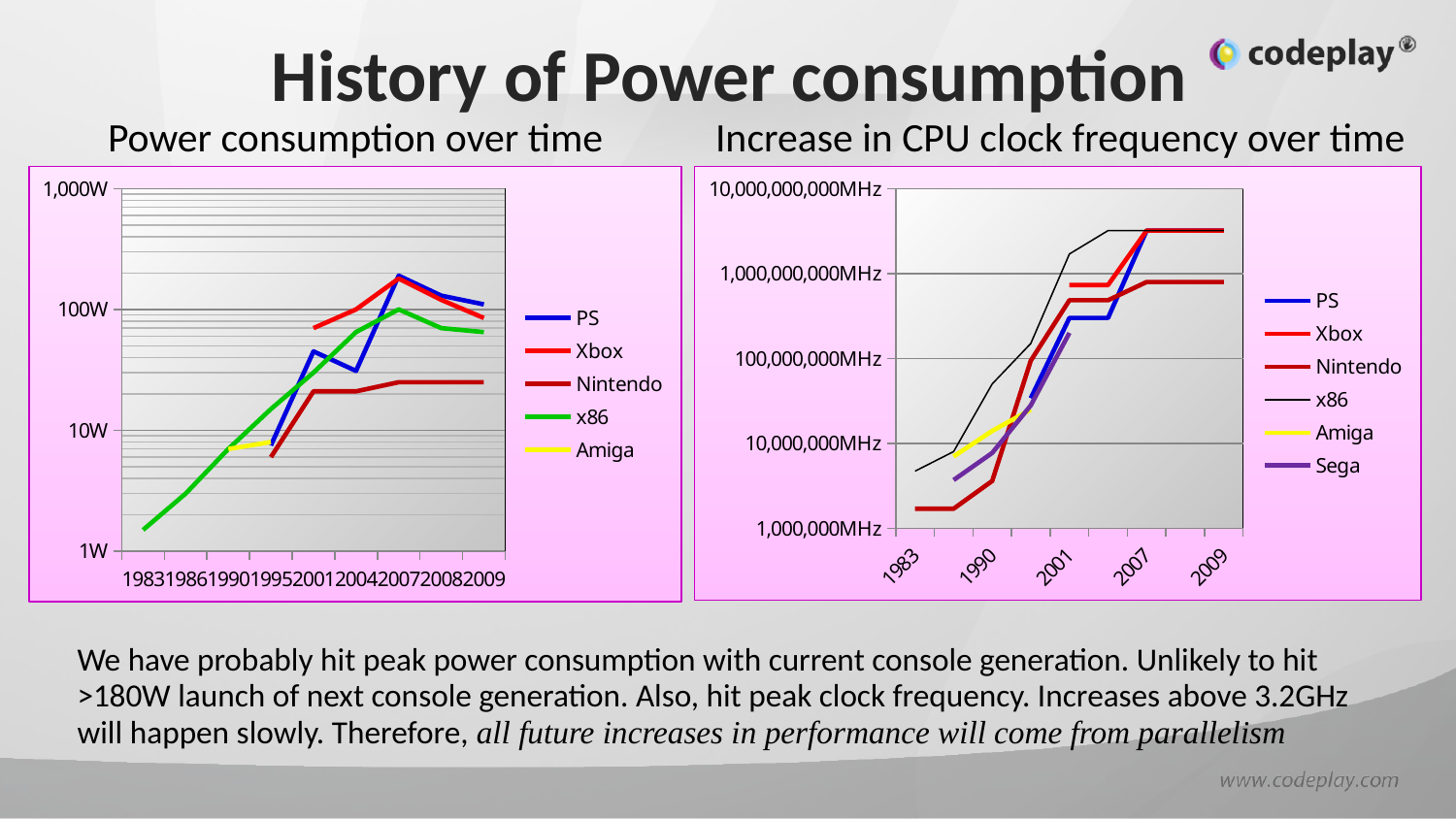
How many series does the legend of the 'Power consumption over time' chart list? 5 In the 'Power consumption over time' chart, does the x86 line rise or fall from 1983 to 2007? rise In the 'Increase in CPU clock frequency over time' chart, which is higher in 2009, Xbox or Nintendo? Xbox In the 'Power consumption over time' chart, how many years are labelled on the x axis? 9 In the 'Increase in CPU clock frequency over time' chart, is the value for Nintendo in 1983 greater or less than 10,000,000MHz? less What kind of chart is the 'Increase in CPU clock frequency over time' chart? line chart Which series appears in the legend of the 'Increase in CPU clock frequency over time' chart but not in the 'Power consumption over time' chart? Sega What kind of chart is the 'Power consumption over time' chart? line chart In the 'Power consumption over time' chart, is the value for x86 in 1983 greater or less than 10W? less In the 'Power consumption over time' chart, is the value for Xbox in 2007 greater or less than 100W? greater How many series does the legend of the 'Increase in CPU clock frequency over time' chart list? 6